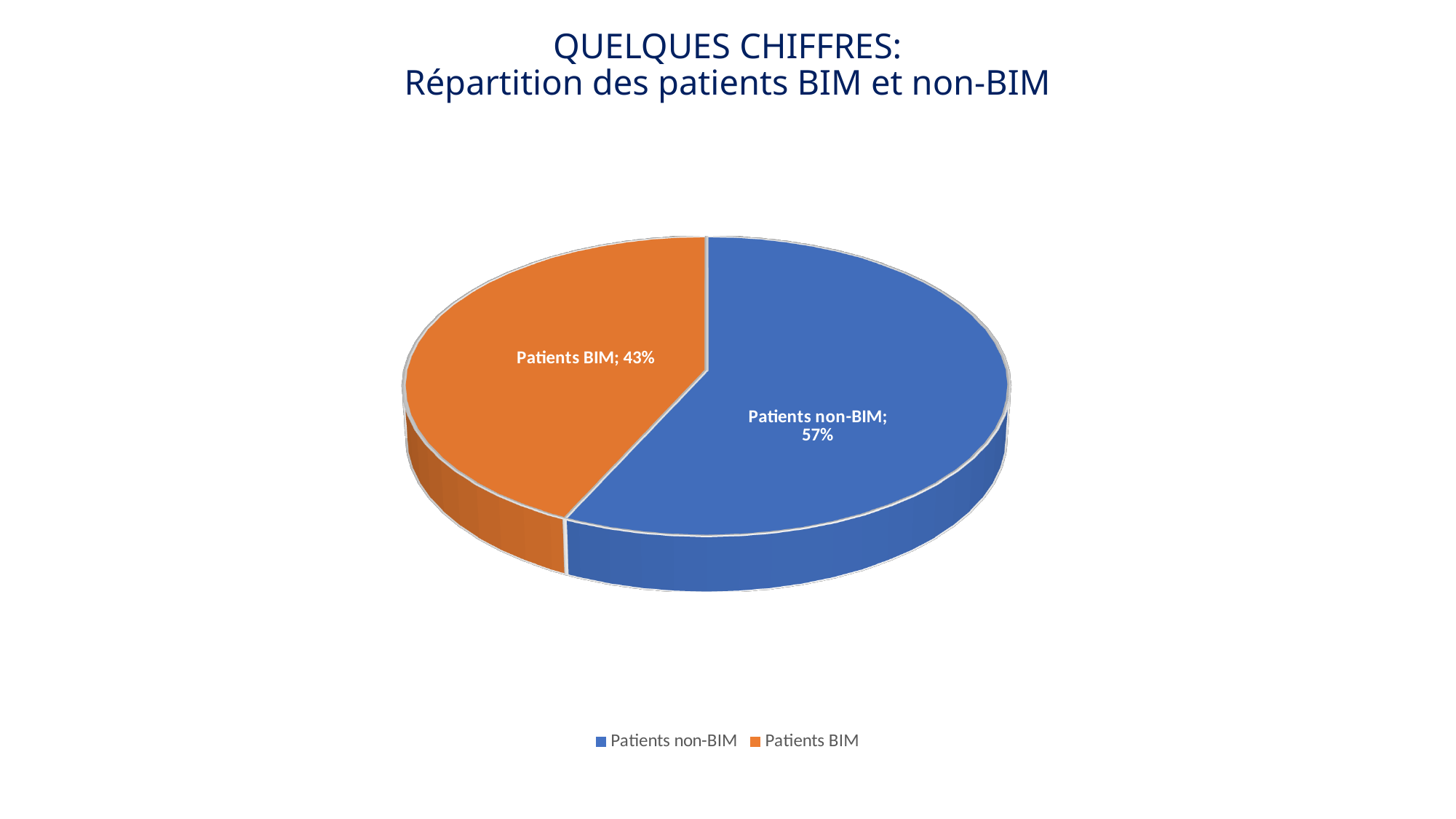
Which slice is the largest? Patients non-BIM What colour is the Patients BIM slice? Orange Which slice is the smallest? Patients BIM Which is larger, Patients BIM or Patients non-BIM? Patients non-BIM How many slices does the pie chart have? 2 How many entries does the legend list? 2 What share of the pie is Patients BIM? 43% What is the title of the slide? QUELQUES CHIFFRES: Répartition des patients BIM et non-BIM What kind of chart is shown on the slide? Pie chart What share of the pie is Patients non-BIM? 57% What is the difference in percentage points between Patients non-BIM and Patients BIM? 14